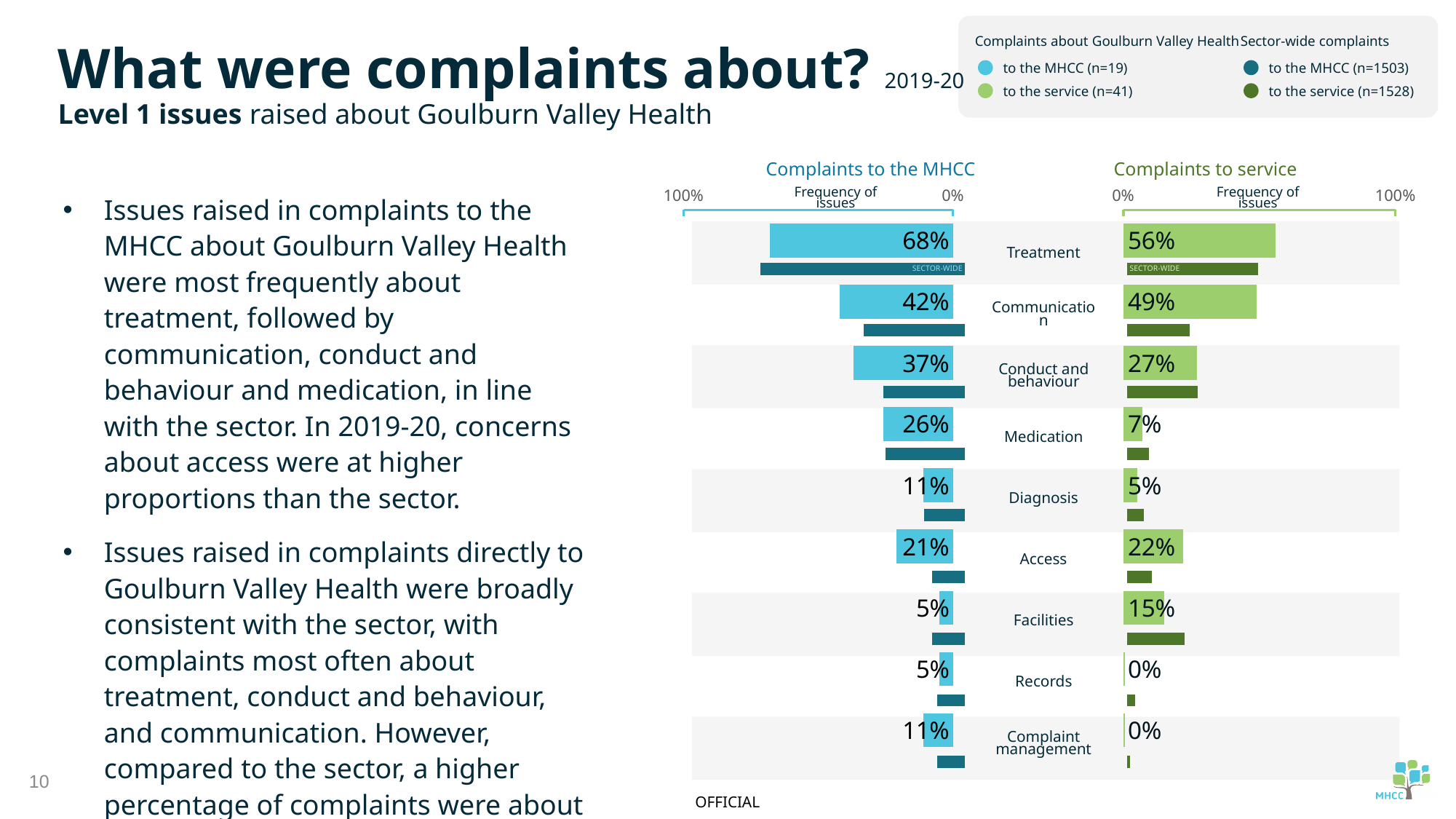
How many categories are shown in the 'Complaints to the MHCC' chart? 9 In the 'Complaints to service' chart, what is the value for Records? 0% In the 'Complaints to service' chart, what is the value for Communication? 49% What kind of chart is the 'Complaints to service' chart? Bar chart In the 'Complaints to service' chart, what is the difference between the values for Conduct and behaviour and Medication? 20% In the 'Complaints to the MHCC' chart, what is the value for Treatment? 68% In the 'Complaints to service' chart, which category has the highest value? Treatment In the 'Complaints to the MHCC' chart, which category has the highest value? Treatment In the 'Complaints to the MHCC' chart, what is the value for Medication? 26% Is the value for Access larger in the 'Complaints to the MHCC' chart or the 'Complaints to service' chart? Complaints to service In the 'Complaints to service' chart, what is the value for Facilities? 15% In the 'Complaints to the MHCC' chart, what is the difference between the values for Treatment and Communication? 26%